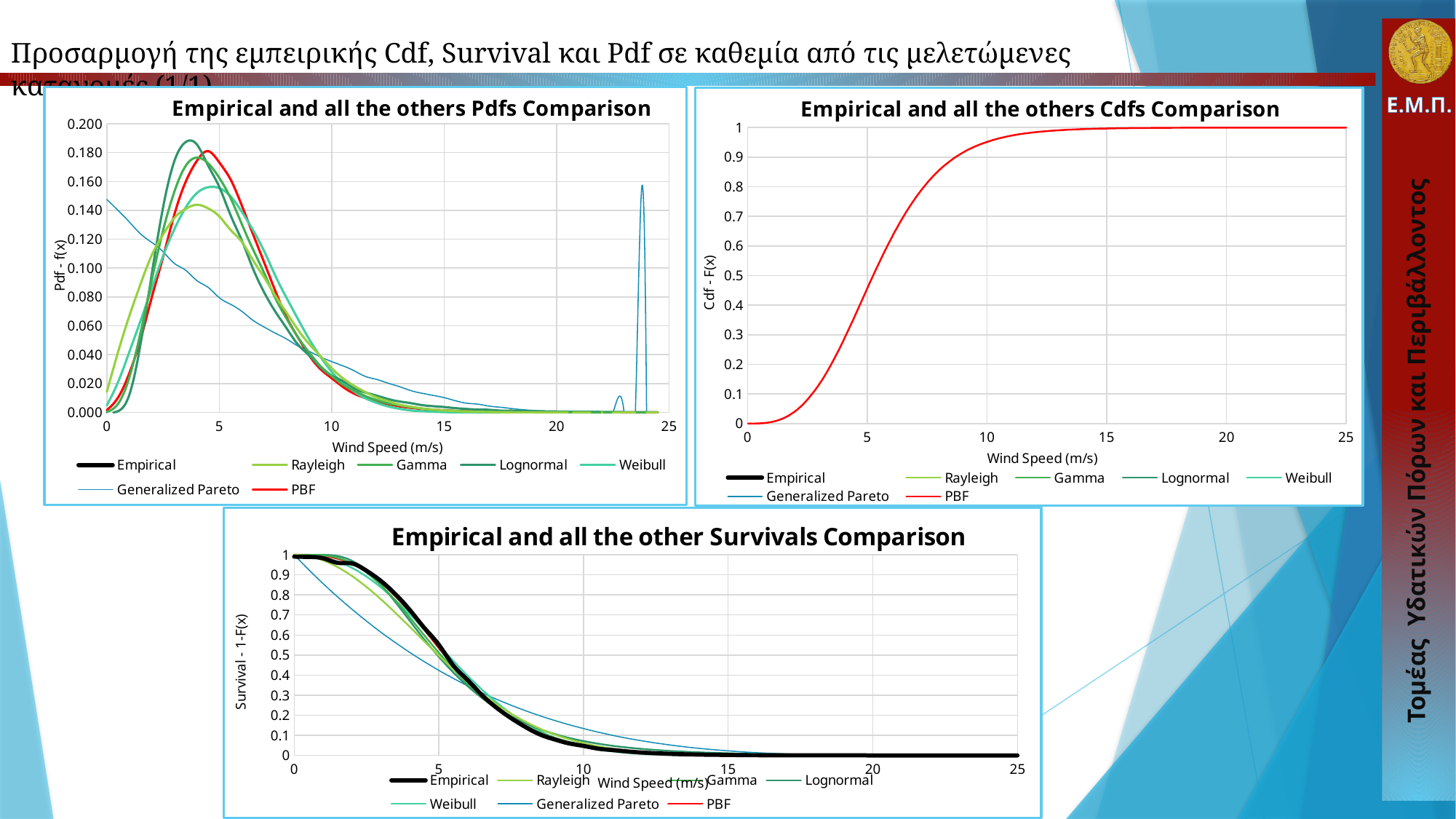
What kind of chart is "Empirical and all the others Pdfs Comparison"? Line chart In "Empirical and all the others Pdfs Comparison", does the Generalized Pareto line rise or fall as wind speed increases from 0 to 10 m/s? Fall How many series does the legend of "Empirical and all the others Pdfs Comparison" list? 7 In "Empirical and all the others Cdfs Comparison", do the values rise or fall as wind speed increases? Rise How many series does the legend of "Empirical and all the other Survivals Comparison" list? 7 In "Empirical and all the others Cdfs Comparison", is the value at wind speed 15 m/s greater or less than 0.9? greater What is the x-axis label of "Empirical and all the others Cdfs Comparison"? Wind Speed (m/s) What is the y-axis label of "Empirical and all the other Survivals Comparison"? Survival - 1-F(x) In "Empirical and all the other Survivals Comparison", is the Empirical value at wind speed 10 m/s greater or less than 0.1? less In "Empirical and all the others Pdfs Comparison", is the peak value of the PBF line greater or less than 0.160? greater In "Empirical and all the other Survivals Comparison", do the values rise or fall as wind speed increases? Fall